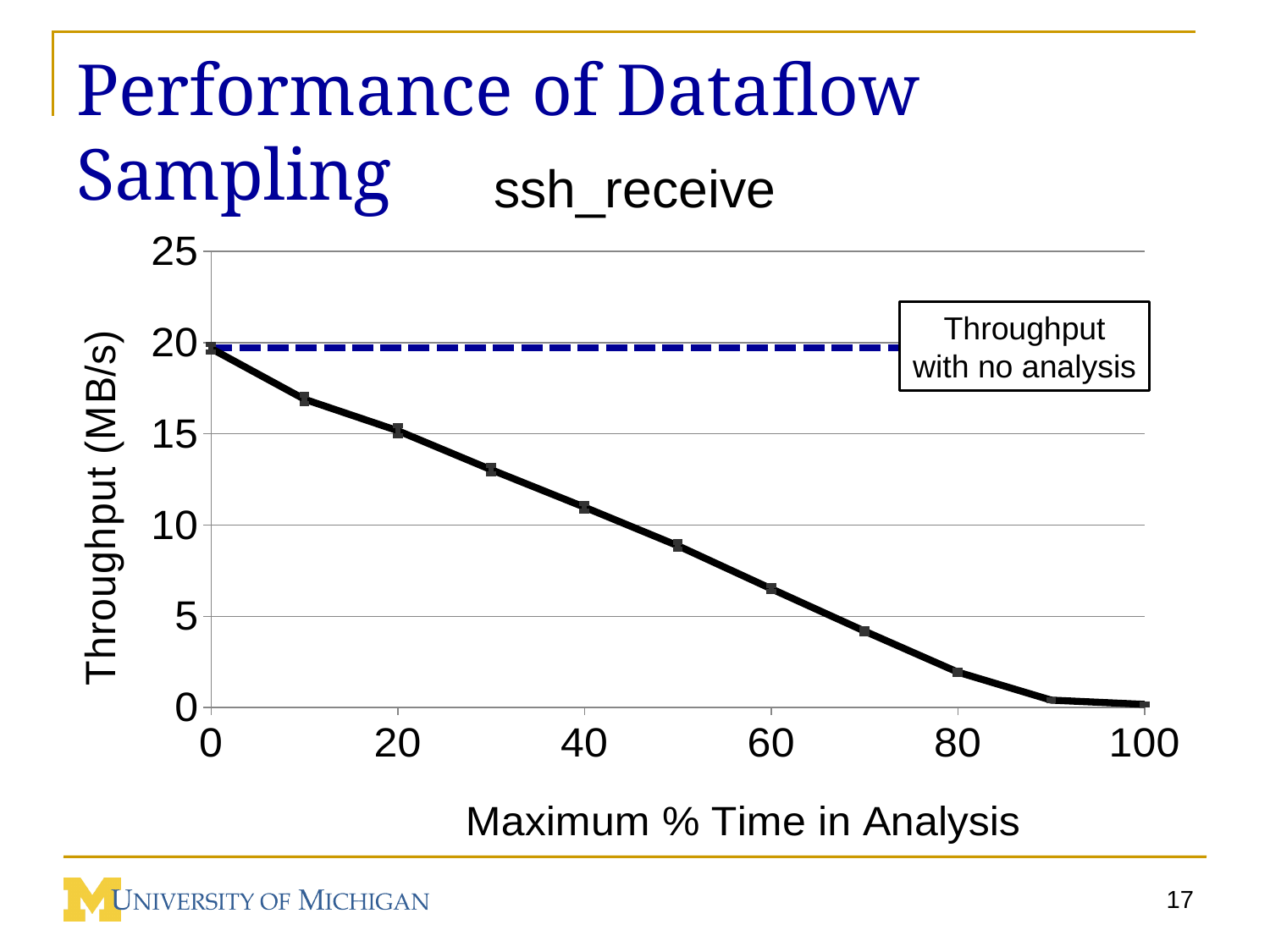
Is the throughput at 80% Maximum Time in Analysis greater or less than 5? less What kind of chart is shown on the slide? line chart At which Maximum % Time in Analysis value is throughput lowest? 100 Is the throughput at 40% Maximum Time in Analysis greater or less than 10? greater Is the throughput at 50% Maximum Time in Analysis greater or less than 10? less At which Maximum % Time in Analysis value is throughput highest? 0 Does throughput rise or fall as Maximum % Time in Analysis increases? fall Which has higher throughput: 20% or 60% Maximum Time in Analysis? 20% What does the dashed horizontal line represent? Throughput with no analysis How many data points are plotted on the solid throughput line? 11 What is the title of the chart? ssh_receive